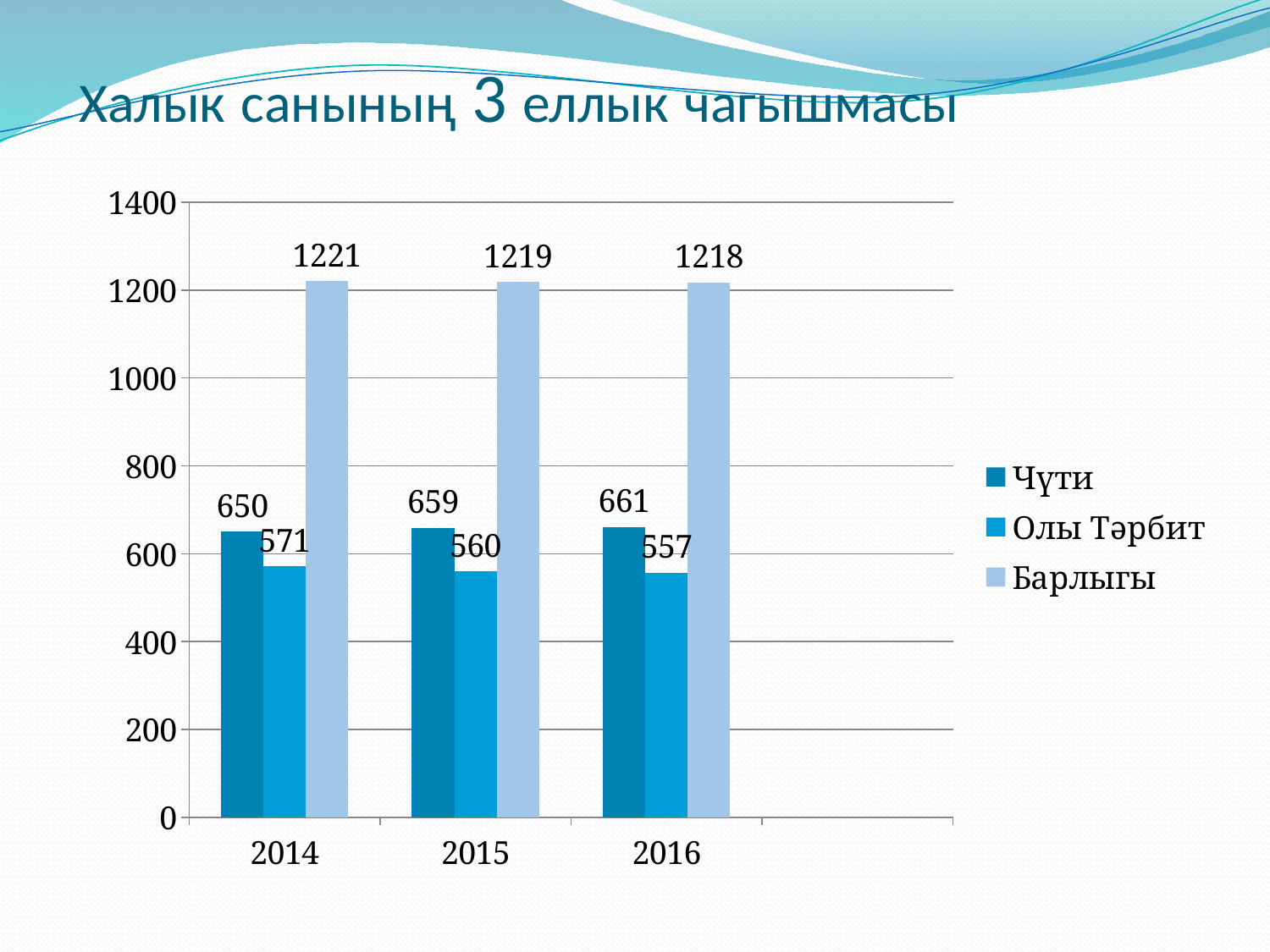
Which is larger in 2015: Чүти or Олы Тәрбит? Чүти How many series does the legend list? 3 Do the Чүти values rise or fall from 2014 to 2016? rise What is the value for Чүти in 2014? 650 What is the value for Олы Тәрбит in 2016? 557 How many years are shown on the x axis? 3 What is the difference between the Чүти values for 2016 and 2014? 11 In which year is the Барлыгы value highest? 2014 What kind of chart is shown on the slide? bar chart What is the value for Барлыгы in 2015? 1219 Is the value for Барлыгы in 2016 greater or less than 1000? greater In which year is the Олы Тәрбит value lowest? 2016